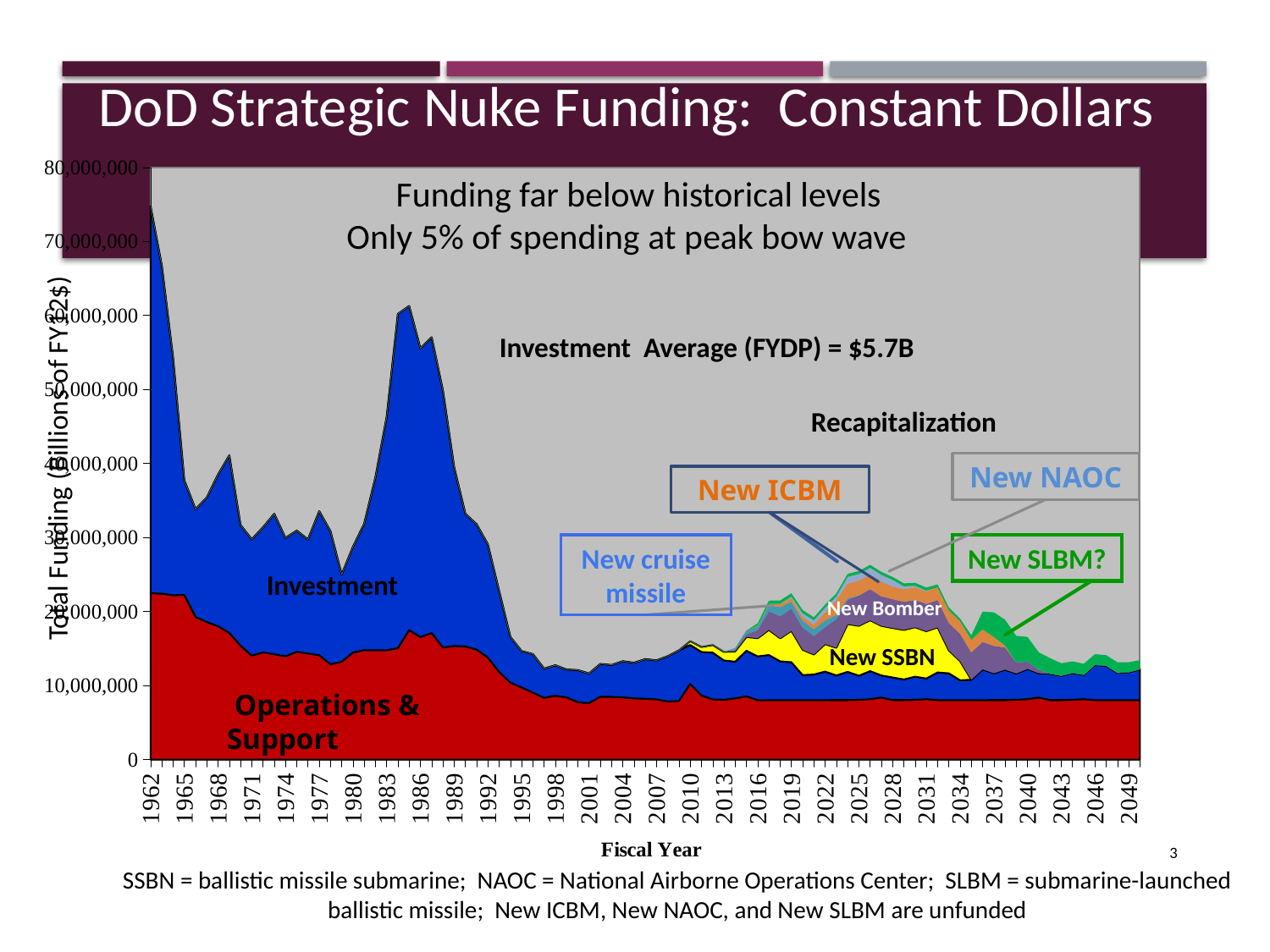
Is the total funding in 2001 greater or less than 20,000,000? less What is the title of the slide's chart? DoD Strategic Nuke Funding: Constant Dollars Does total funding rise or fall from 1986 to 1998? fall Which is larger, the Operations & Support funding in 1962 or in 2049? 1962 Is the Operations & Support funding in 2049 greater or less than 10,000,000? less Is the total funding in 1962 greater or less than 70,000,000? greater What investment average (FYDP) is stated on the chart? $5.7B What kind of chart is shown on the slide? area chart In which fiscal year is total funding highest? 1962 Which is larger, the total funding in 1962 or in 1984? 1962 What is the label on the x axis of the chart? Fiscal Year